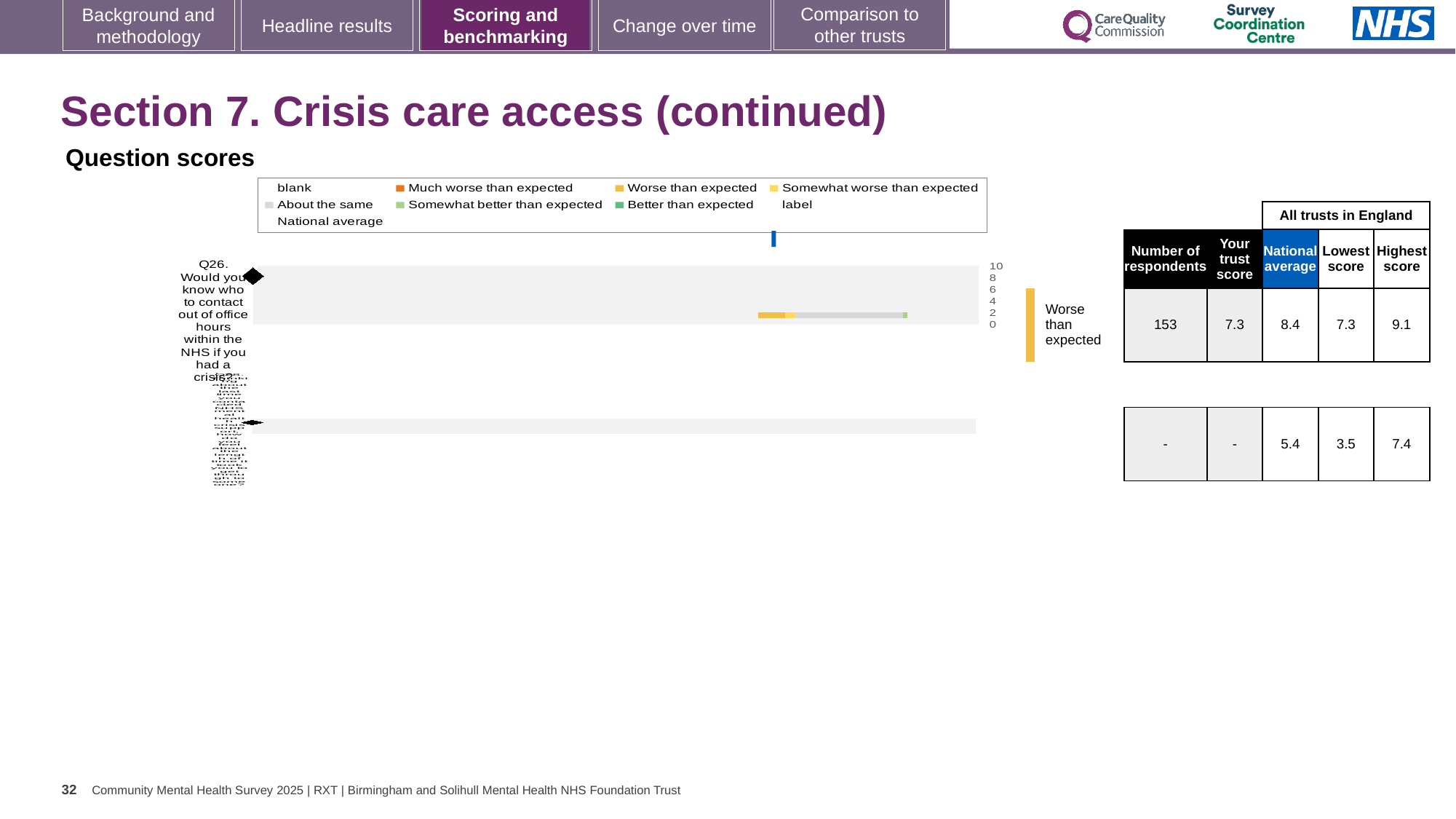
What kind of chart is used to show the Q26 question score? bar chart What benchmark category label is shown next to the bar for Q26? Worse than expected In the table beside the chart, what is the national average for Q26? 8.4 In the table beside the chart, what is the number of respondents for Q26? 153 What colour does the legend use for 'Much worse than expected'? orange For Q26, what is the difference between the highest and lowest scores among all trusts in England? 1.8 In the table beside the chart, what is the highest score among all trusts in England for Q26? 9.1 In the table beside the chart, what is the lowest score among all trusts in England for Q26? 7.3 For Q26, which is larger: the trust's score or the national average? the national average For Q26, how much higher is the national average than the trust's score? 1.1 In the table beside the chart, what is the trust's score for Q26? 7.3